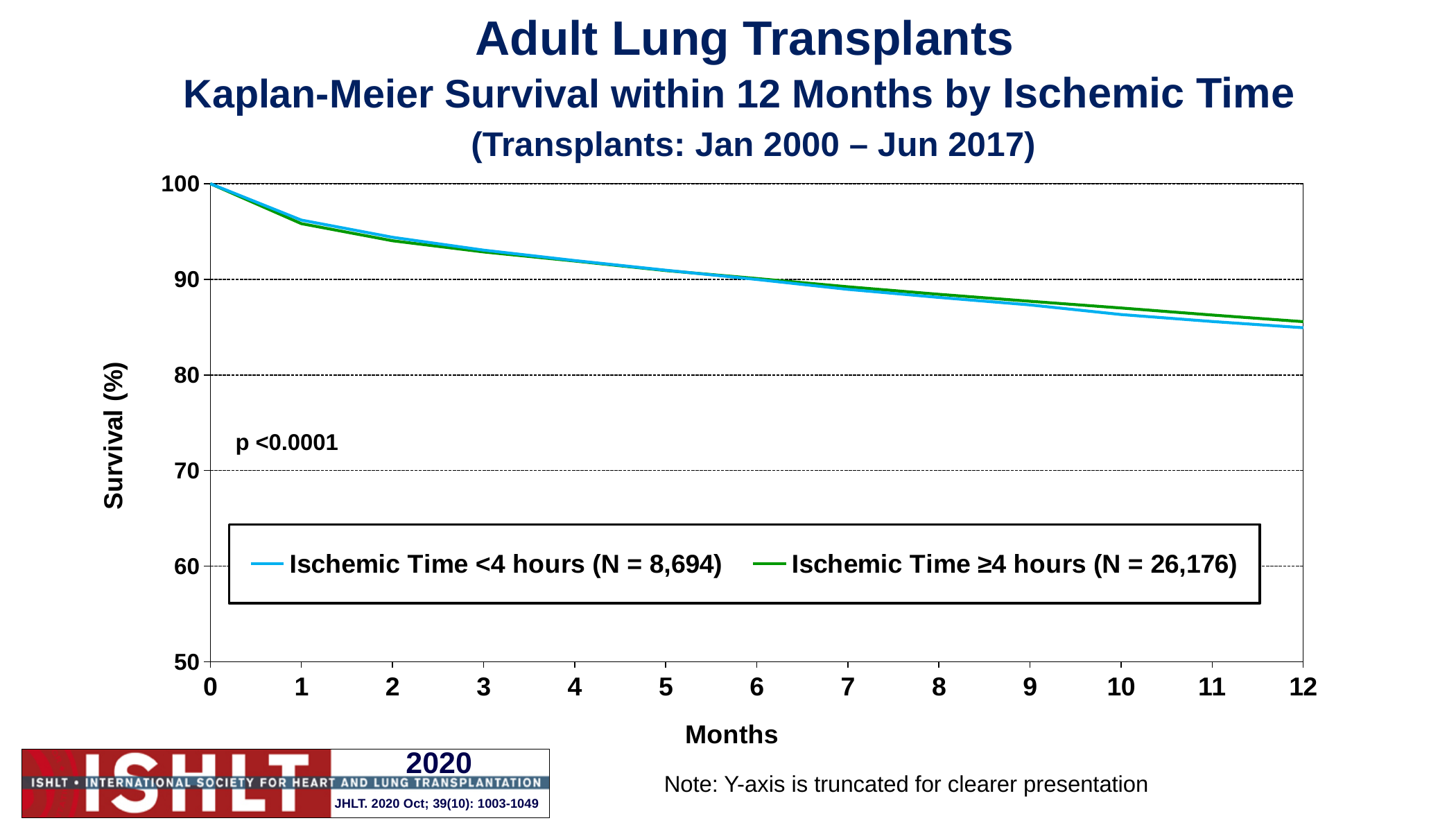
Do the survival values rise or fall as months increase? fall Is the survival value for Ischemic Time ≥4 hours at 12 months greater or less than 80? greater Is the survival value for Ischemic Time <4 hours at 12 months greater or less than 90? less What is the N for the Ischemic Time ≥4 hours group shown in the legend? 26,176 What is the survival value for both series at 0 months? 100 How many series does the legend list? 2 Is the survival value for Ischemic Time <4 hours at 1 month greater or less than 90? greater What is the label of the y-axis? Survival (%) What kind of chart is shown on the slide? line chart What is the N for the Ischemic Time <4 hours group shown in the legend? 8,694 What p-value is printed on the chart? p <0.0001